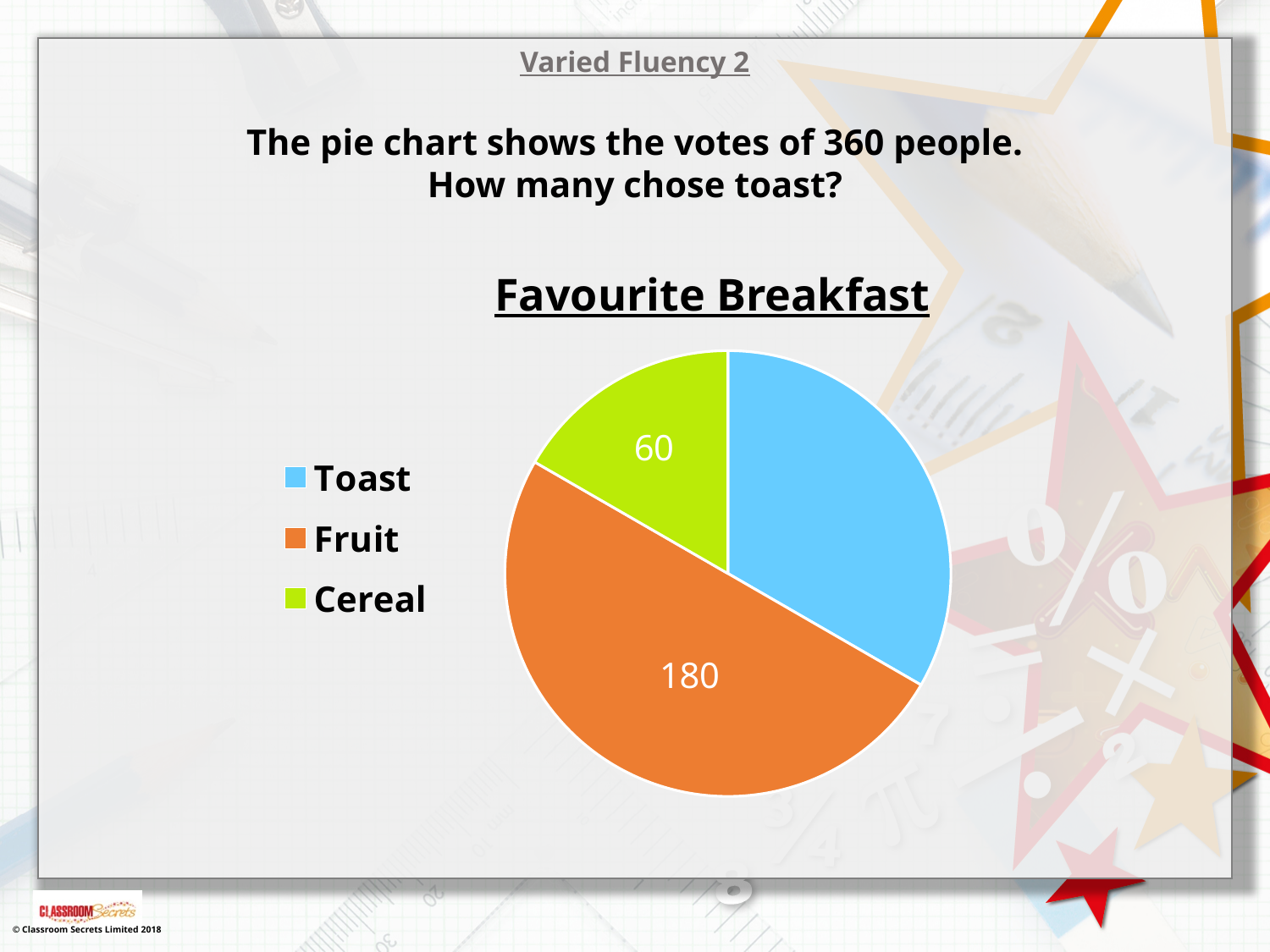
How many entries does the legend list? 3 What kind of chart is shown on the slide? Pie chart Which slice is larger, Toast or Cereal? Toast What is the title of the chart? Favourite Breakfast What is the difference between the Fruit value and the Cereal value? 120 How many categories are shown in the pie chart? 3 Which category has the largest slice of the pie? Fruit What is the value shown for the Cereal slice? 60 What colour is the Toast slice? Blue Which slice is larger, Fruit or Toast? Fruit What is the value shown for the Fruit slice? 180 Which category has the smallest slice of the pie? Cereal